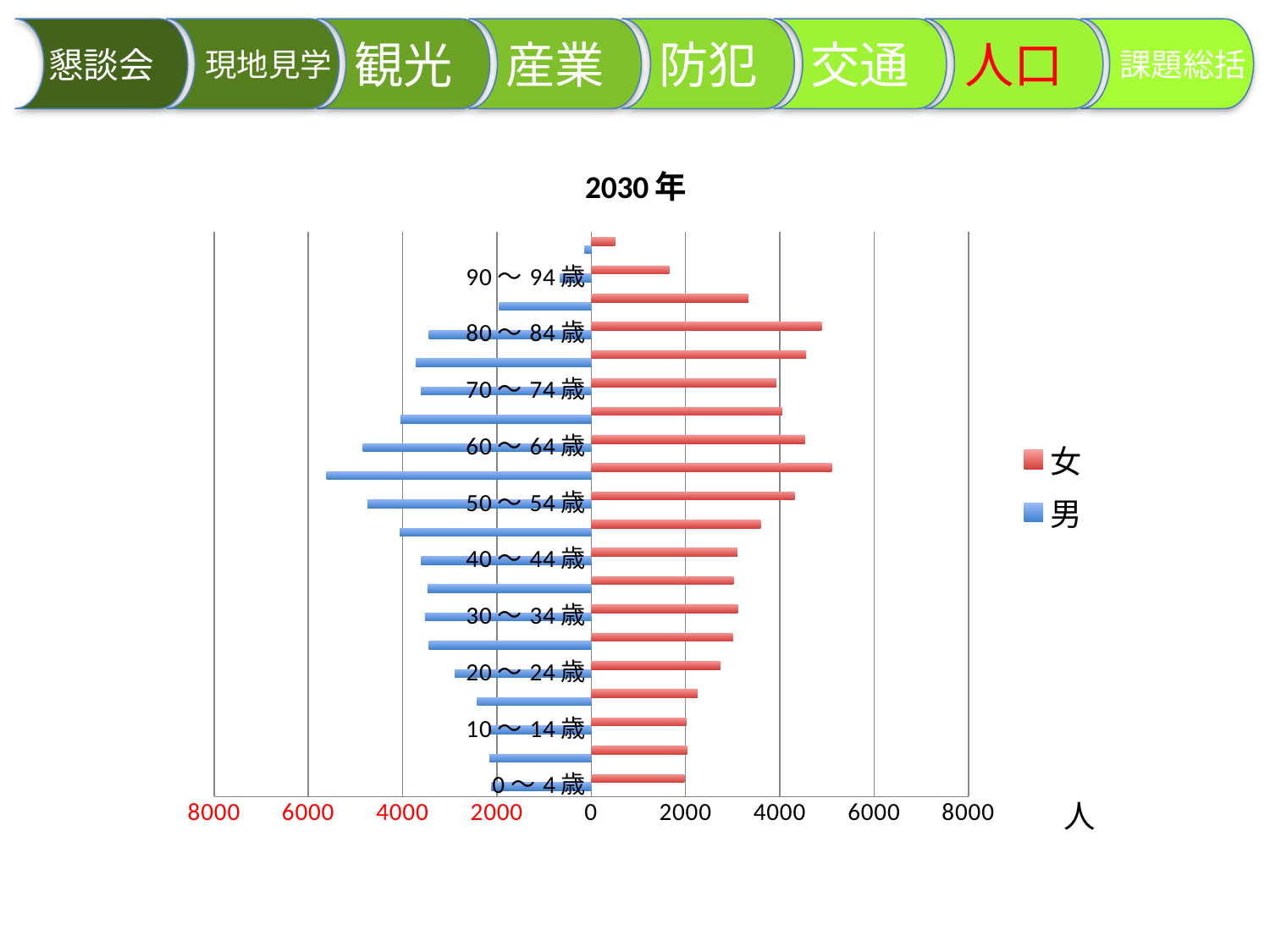
What kind of chart is shown on the slide? bar chart Is the value for 男 in the 60〜64歳 group greater or less than 4000? greater Is the value for 男 in the 80〜84歳 group greater or less than 4000? less How many series does the legend list? 2 Is the value for 女 in the 90〜94歳 group greater or less than 2000? less Which two series are listed in the legend? 女 and 男 In the 80〜84歳 group, which series has the larger value, 女 or 男? 女 In the 50〜54歳 group, which series has the larger value, 女 or 男? 男 What is the title of the chart? 2030年 How many age-group bars are plotted for each series? 20